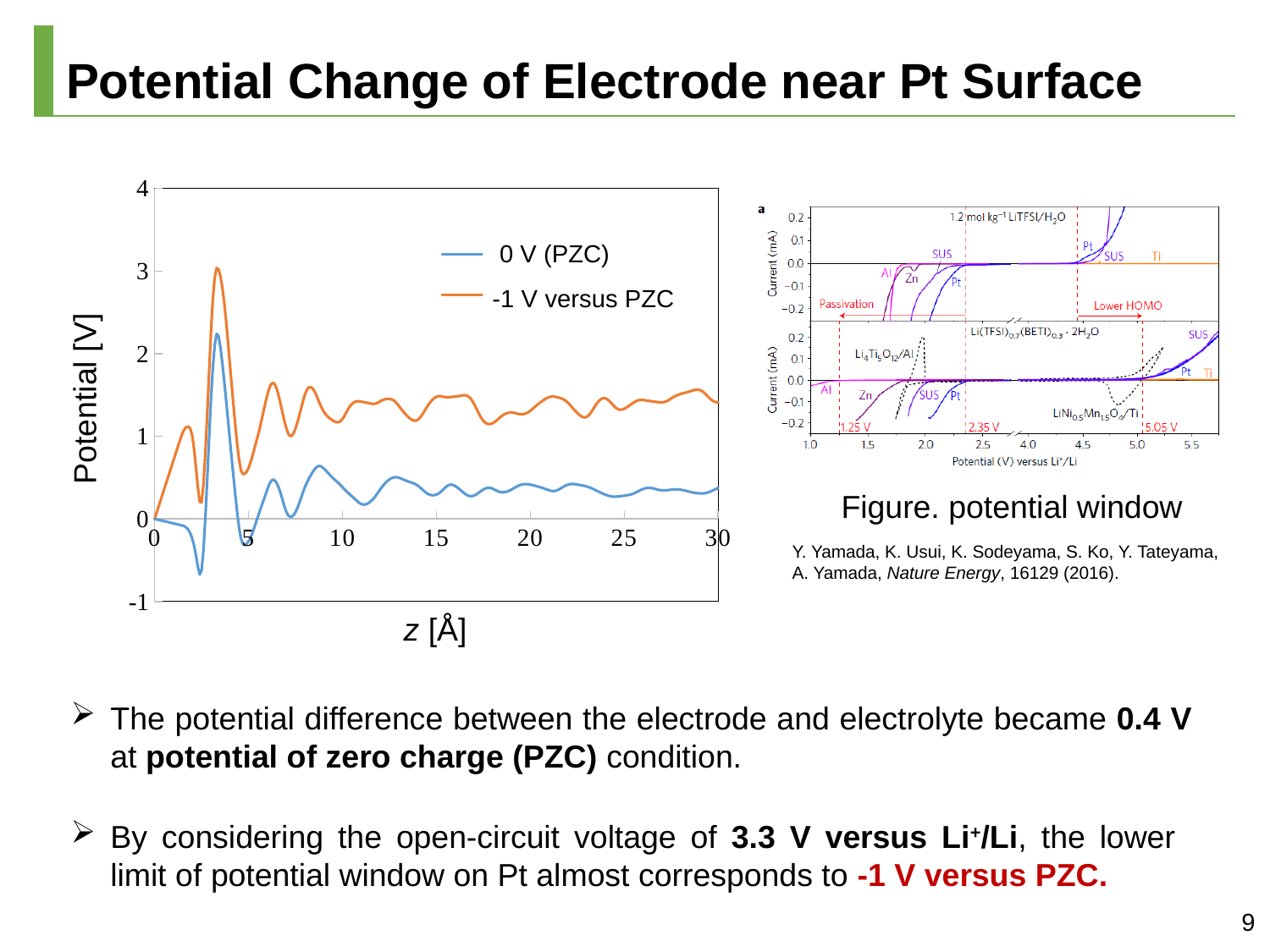
In the left chart, is the minimum value of the 0 V (PZC) curve greater or less than 0? less In the left chart, at z = 30 Å, is the 0 V (PZC) curve greater or less than 1? less In the potential window figure on the right, what potential is marked by the red dashed line labelled at the far right of the lower panel? 5.05 V In the left chart, is the peak value of the -1 V versus PZC curve greater or less than 2? greater In the potential window figure on the right, what is the x-axis label? Potential (V) versus Li+/Li In the left chart, which series reaches the higher peak potential? -1 V versus PZC How many series does the legend of the left chart list? 2 What are the two series named in the legend of the left chart? 0 V (PZC) and -1 V versus PZC What kind of chart is the left chart with the x axis z [Å]? line chart In the left chart, which series has the higher potential at z = 30 Å? -1 V versus PZC What is the y-axis label of the left chart? Potential [V]